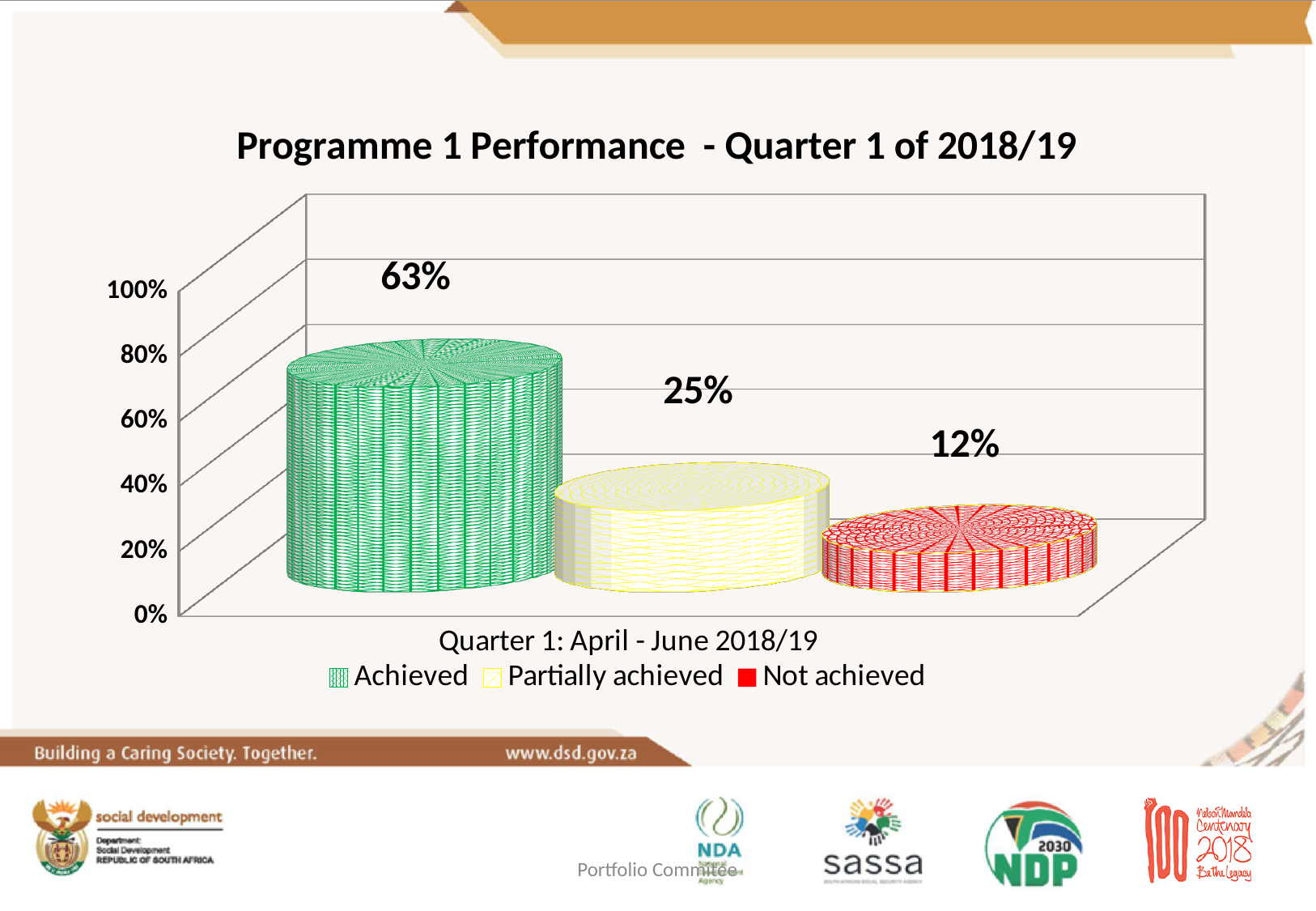
What is the title of the chart? Programme 1 Performance - Quarter 1 of 2018/19 Which series has the highest value? Achieved Which is larger, Partially achieved or Not achieved? Partially achieved What is the value for Not achieved? 12% What kind of chart is shown? Bar chart What is the category label on the x axis? Quarter 1: April - June 2018/19 What is the difference between the Partially achieved and Not achieved values? 13% What is the difference between the Achieved and Partially achieved values? 38% Which series has the lowest value? Not achieved How many series does the legend list? 3 What is the value for Achieved? 63% What is the value for Partially achieved? 25%